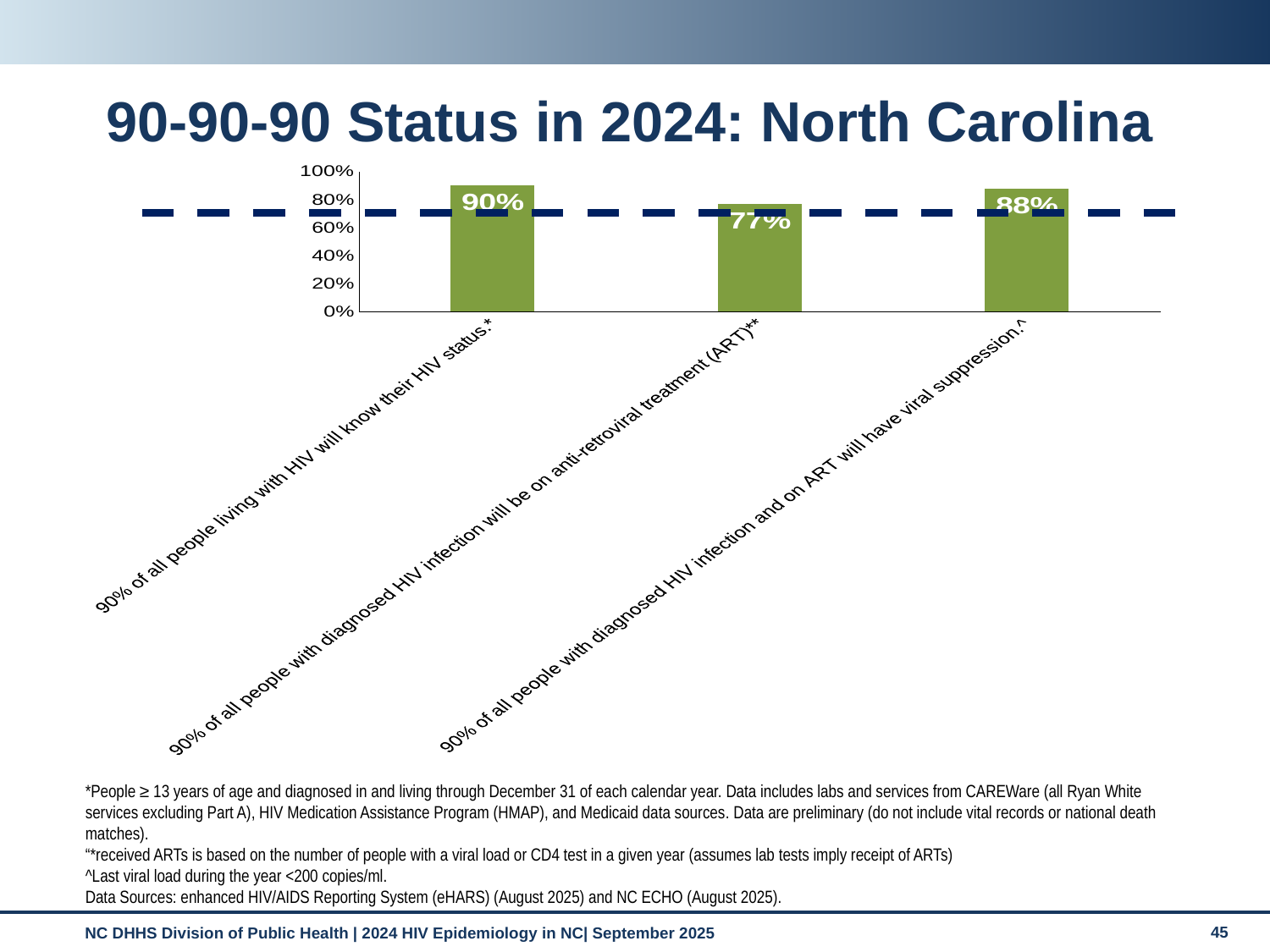
How many bars are shown in the chart? 3 What is the difference between the percentage with viral suppression and the percentage on ART? 11% What type of chart is shown on the slide? Bar chart Which is larger: the percentage who know their HIV status or the percentage with viral suppression? The percentage who know their HIV status What percentage of all people with diagnosed HIV infection and on ART have viral suppression? 88% What percentage of all people with diagnosed HIV infection are on anti-retroviral treatment (ART)? 77% Which of the three 90-90-90 measures has the lowest value? 90% of all people with diagnosed HIV infection will be on anti-retroviral treatment (ART) What is the title of the slide containing the chart? 90-90-90 Status in 2024: North Carolina What percentage of all people living with HIV know their HIV status? 90% What is the difference between the percentage who know their HIV status and the percentage on ART? 13% Is the value for people on ART greater or less than 80%? less Which of the three 90-90-90 measures has the highest value? 90% of all people living with HIV will know their HIV status